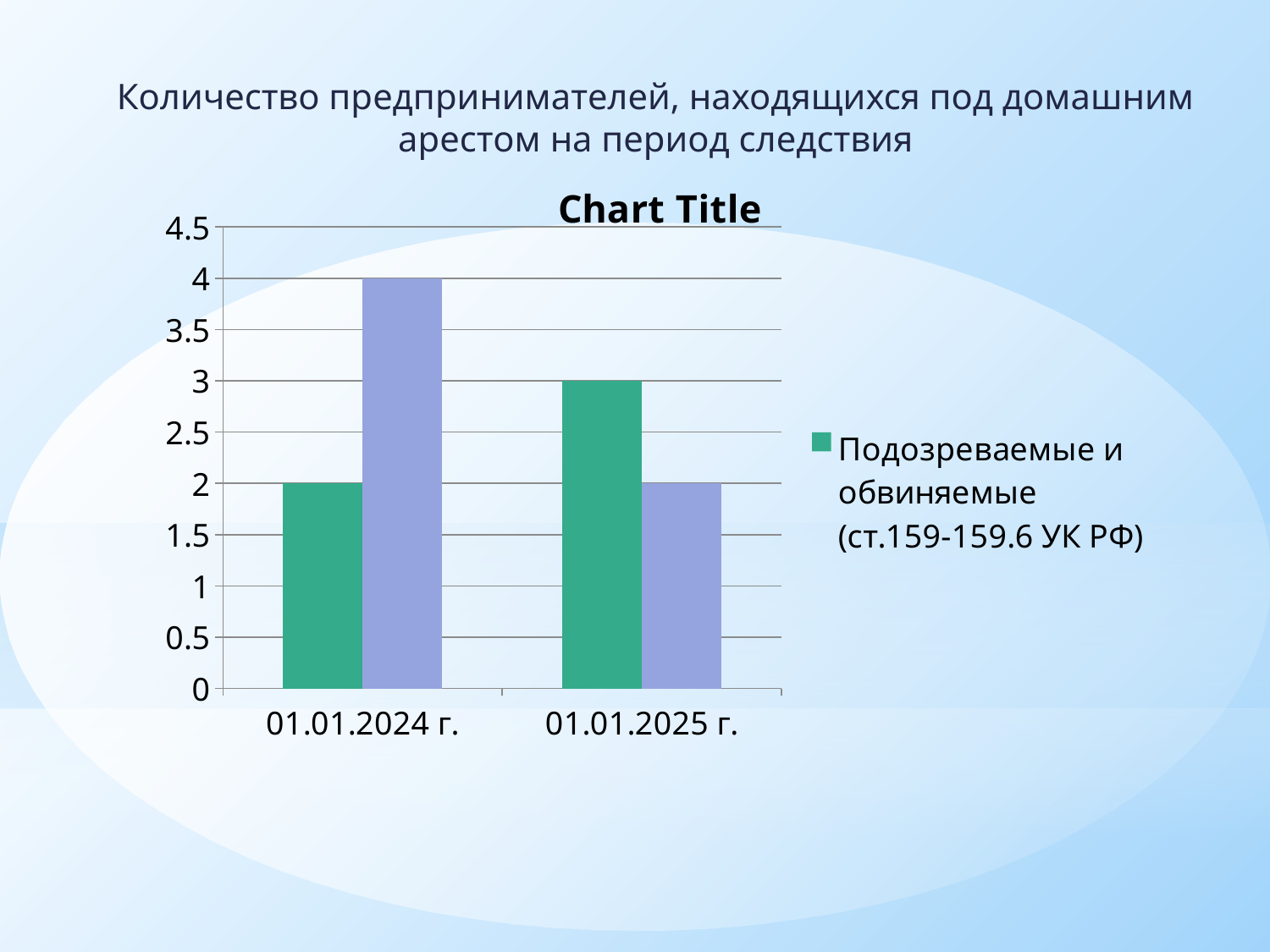
How many series does the legend list? 1 What is the value of the purple bar at 01.01.2024 г.? 4 What is the value for "Подозреваемые и обвиняемые (ст.159-159.6 УК РФ)" at 01.01.2024 г.? 2 How many categories are shown on the x axis? 2 What type of chart is shown on the slide? bar chart What is the value for "Подозреваемые и обвиняемые (ст.159-159.6 УК РФ)" at 01.01.2025 г.? 3 What is the value of the purple bar at 01.01.2025 г.? 2 Does the value of the purple bars rise or fall from 01.01.2024 г. to 01.01.2025 г.? fall Which is larger at 01.01.2025 г.: the green bar or the purple bar? the green bar What is the difference between the purple bar and the green bar at 01.01.2024 г.? 2 What is the title printed above the plot area of the chart? Chart Title Does the value for "Подозреваемые и обвиняемые (ст.159-159.6 УК РФ)" rise or fall from 01.01.2024 г. to 01.01.2025 г.? rise